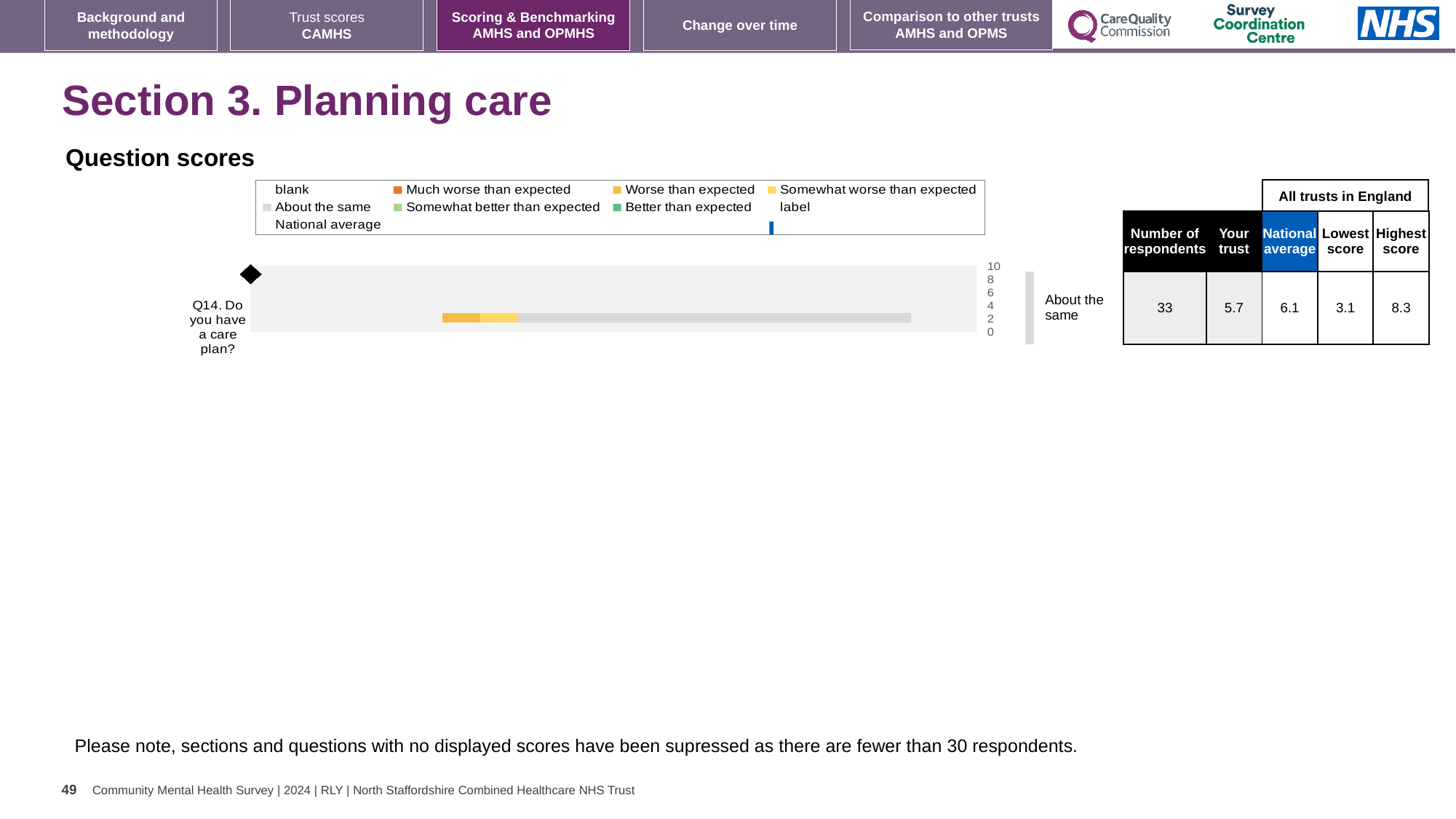
How many questions are plotted in the Question scores chart? 1 What is the highest score among all trusts in England for Q14? 8.3 How many respondents answered Q14? 33 What kind of chart is used to show the Q14 question score? bar chart Which is larger for Q14, the 'Your trust' score or the national average? National average Which question is plotted in the Question scores chart? Q14. Do you have a care plan? What is the lowest score among all trusts in England for Q14? 3.1 What is the difference between the highest and lowest scores for Q14? 5.2 What is the 'Your trust' score for Q14? 5.7 What is the national average score for Q14? 6.1 Which benchmarking category is shown for Q14 next to the chart? About the same Is the 'Your trust' score for Q14 greater or less than 6? less